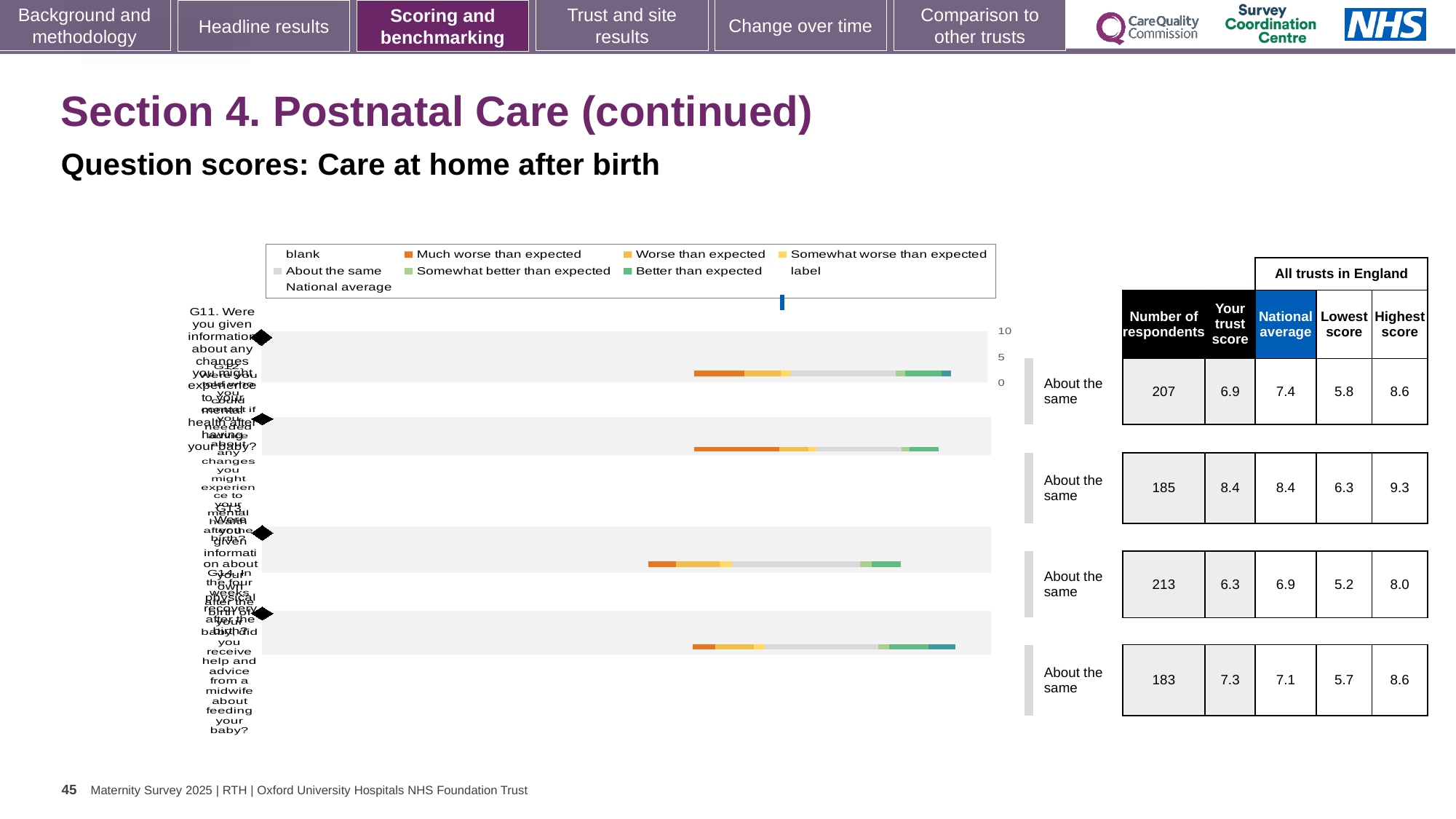
Which row of the table has the highest 'Your trust score'? the second row (8.4) Which row of the table has the lowest 'Your trust score'? the third row (6.3) What heading appears above the National average, Lowest score and Highest score columns in the table? All trusts in England In the table, what is the number of respondents for the first (top) row, question G11? 207 In the table, what is the national average for the third row? 6.9 In the table, what is 'Your trust score' for the second row? 8.4 For the first row (G11), what is the difference between the national average and your trust score? 0.5 How many question rows (bars) are plotted in the chart? 4 For the fourth (bottom) row, which is larger: your trust score or the national average? your trust score (7.3) In the table, what is the highest score for the second row? 9.3 What benchmark category is shown for every row in the chart? About the same What kind of chart is shown on the slide? bar chart